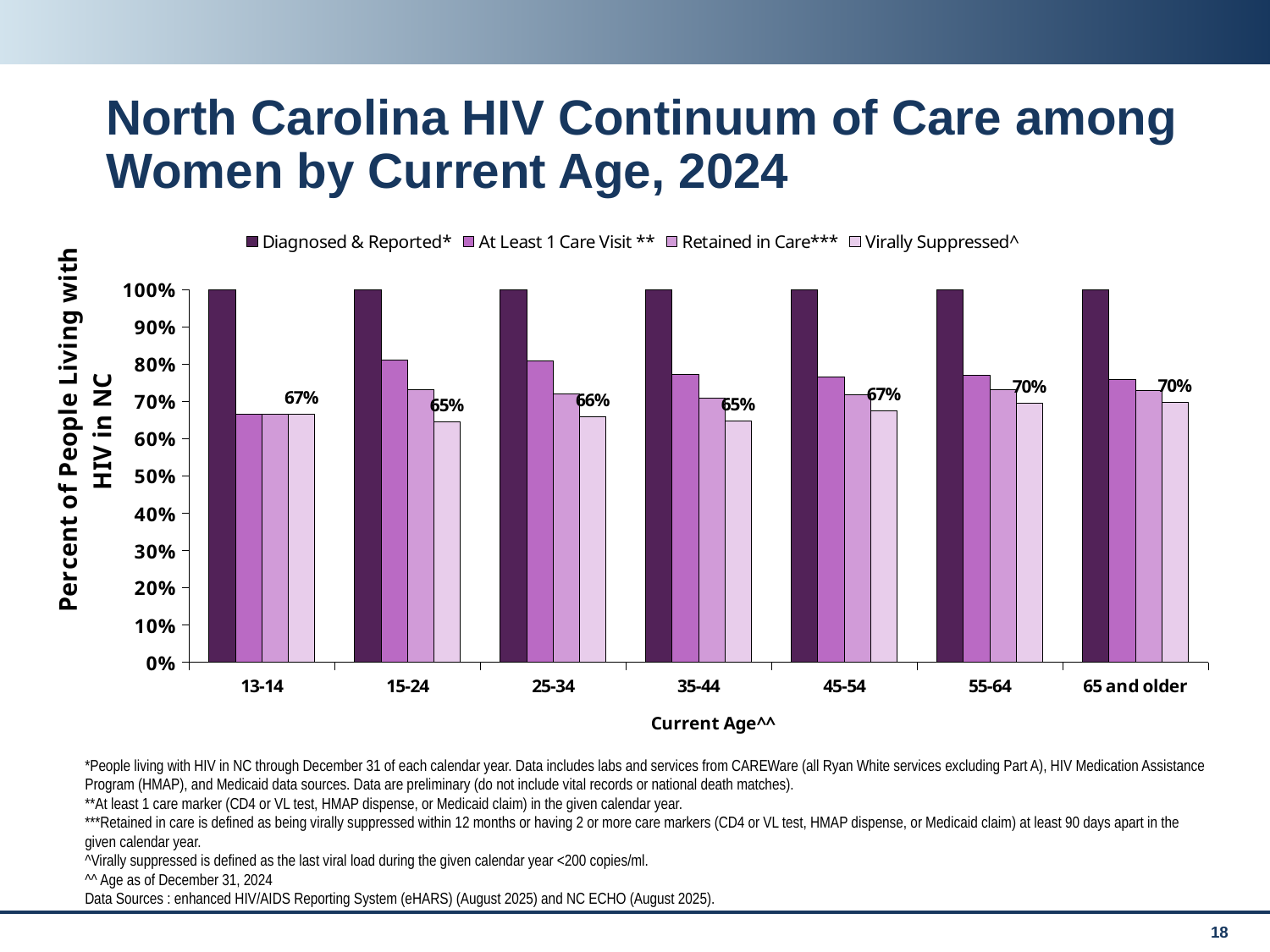
What is the difference in percentage points between the Virally Suppressed^ values for 55-64 and 35-44? 5 percentage points Is the Retained in Care*** value for the 13-14 age group greater or less than 70%? less What kind of chart is shown on the slide? Bar chart How many age groups are shown on the x axis? 7 What is the Virally Suppressed^ value for the 25-34 age group? 66% What is the Virally Suppressed^ value for the 13-14 age group? 67% Which age group has the larger Virally Suppressed^ value, 13-14 or 15-24? 13-14 What is the Virally Suppressed^ value for the 65 and older age group? 70% What is the Virally Suppressed^ value for the 15-24 age group? 65% What is the Diagnosed & Reported* value for the 45-54 age group? 100% Is the At Least 1 Care Visit ** value for the 35-44 age group greater or less than 70%? greater How many series does the legend list? 4